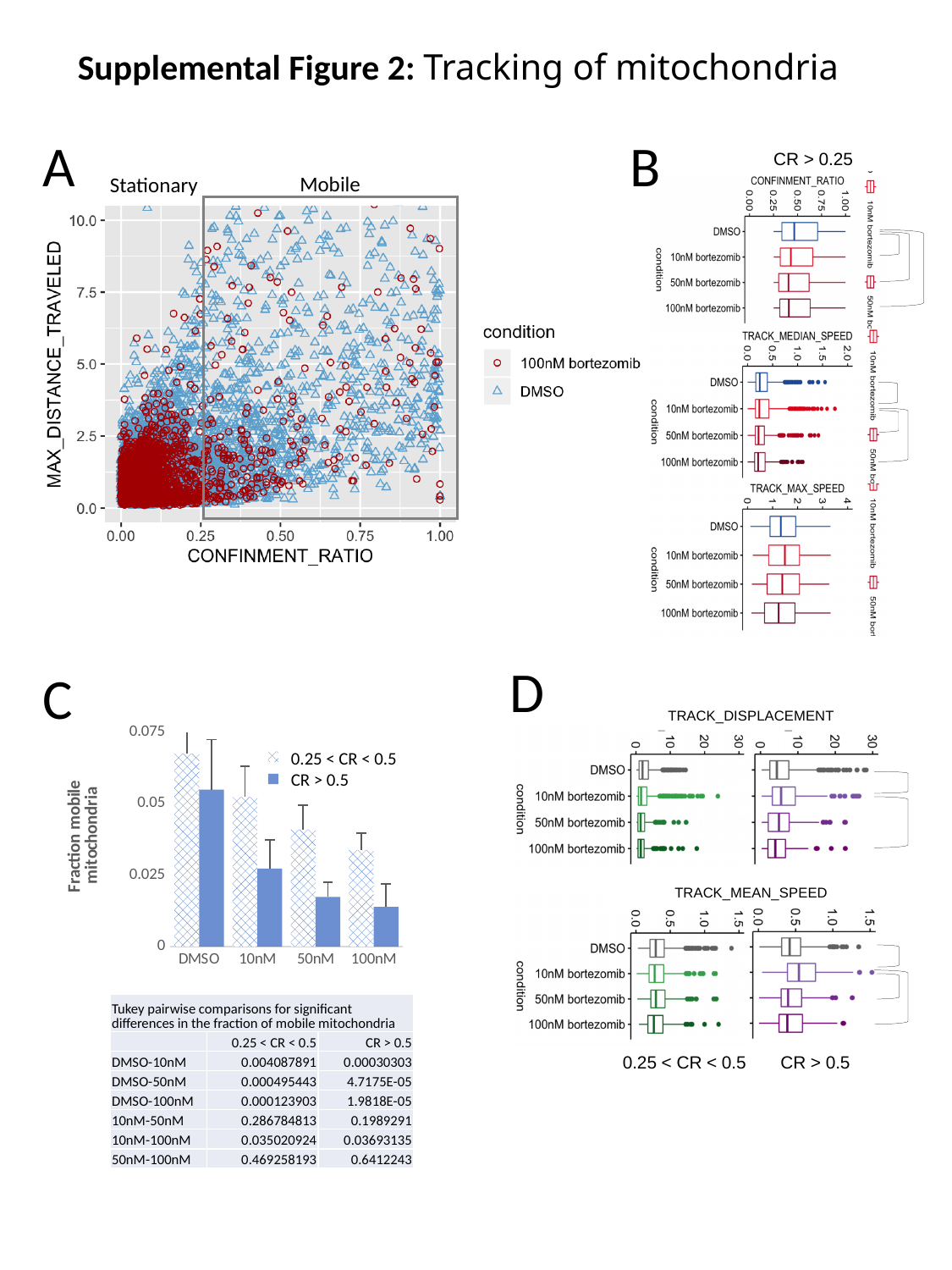
In panel C, is the CR > 0.5 value for 100nM greater or less than 0.025? less In panel A, which condition is plotted with triangles? DMSO In panel C, does the fraction of mobile mitochondria for CR > 0.5 rise or fall from DMSO to 100nM? fall In panel C, which category has the highest fraction of mobile mitochondria for CR > 0.5? DMSO In panel C, what kind of chart is shown? bar chart In panel A, what kind of chart is shown? scatter plot In panel A, what is the label of the x axis? CONFINMENT_RATIO In panel C, is the 0.25 < CR < 0.5 value for DMSO greater or less than 0.05? greater In panel A, how many conditions does the legend list? 2 In panel B, how many conditions are shown on the y axis of the CONFINMENT_RATIO box plot? 4 In panel C, how many treatment categories are shown on the x axis? 4 In panel C, how many series does the legend list? 2